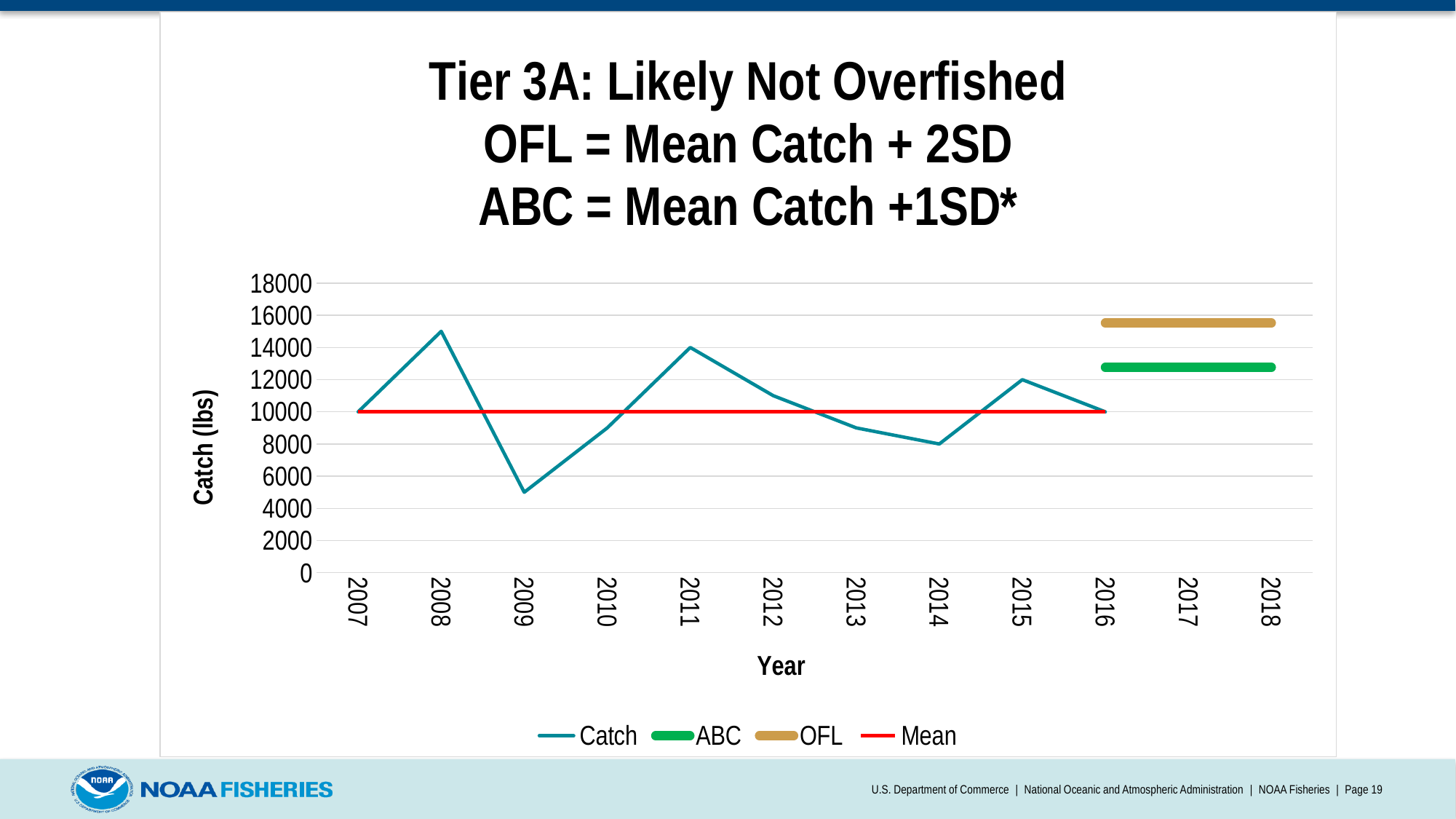
Is the Catch value for 2009 greater or less than 6000? less Is the OFL value greater or less than 14000? greater What is the title of the y axis? Catch (lbs) What is the Catch value for 2014? 8000 How many series does the legend list? 4 What is the value of the Mean line? 10000 Which year has the lowest Catch value? 2009 Which is larger, the OFL value or the ABC value? OFL How many years are labelled on the x axis? 12 What kind of chart is shown on the slide? line chart Which year has the highest Catch value? 2008 Is the Catch value for 2008 greater or less than 14000? greater